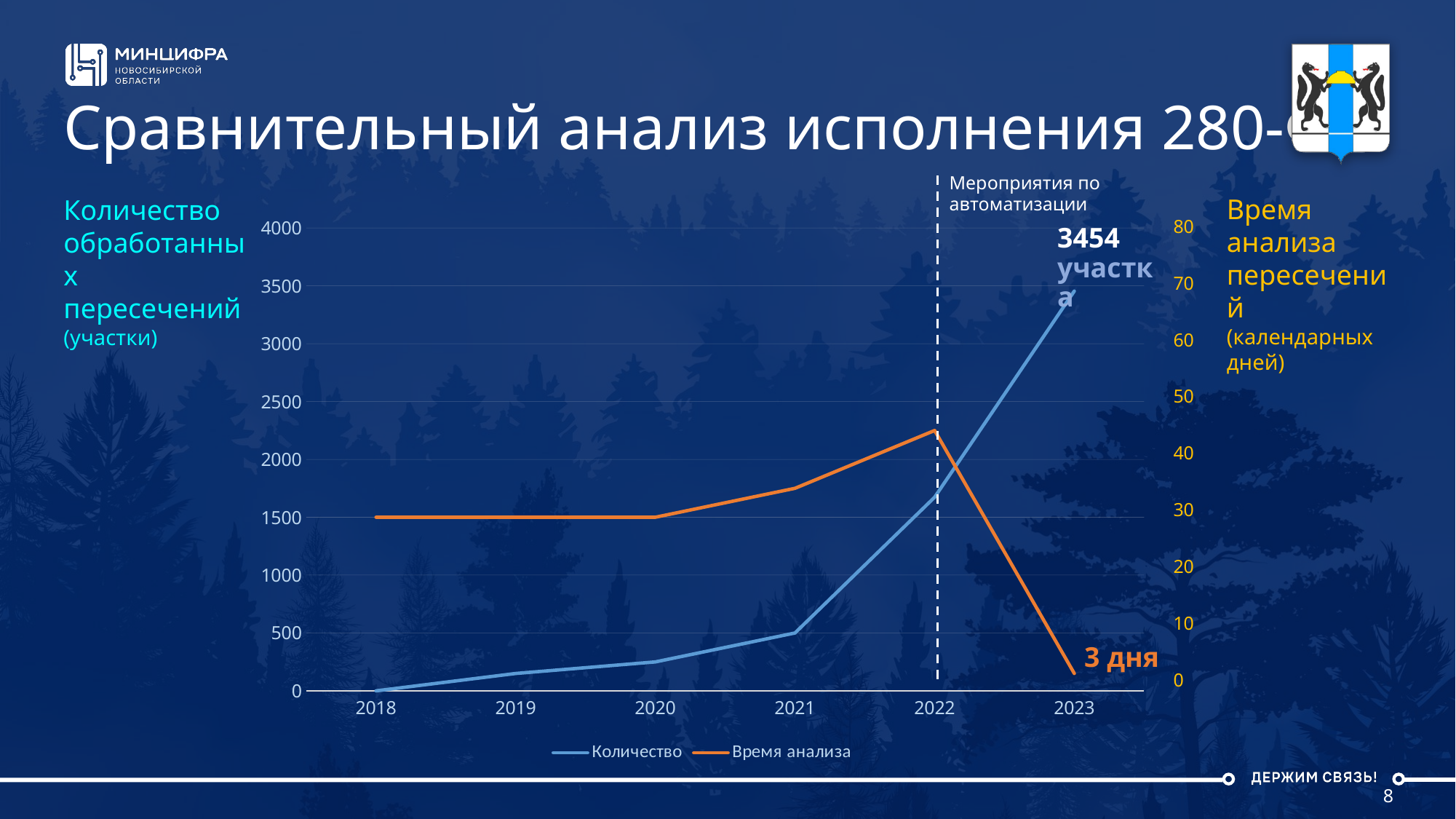
What is the value of the Время анализа series in 2023 according to the data label? 3 дня Is the value of the Время анализа series in 2022 greater or less than 40? greater How many years are plotted along the x axis of the chart? 6 What type of chart is shown on the slide? line chart In which year does the Количество series reach its highest value? 2023 Is the value of the Количество series in 2022 greater or less than 1500? greater In which year is the Количество series at its lowest value? 2018 How many series does the chart legend list? 2 Does the Количество series rise or fall from 2018 to 2023? rise In which year does the Время анализа series reach its highest value? 2022 In which year is the Время анализа series at its lowest value? 2023 What is the value of the Количество series in 2023 according to the data label? 3454 участка